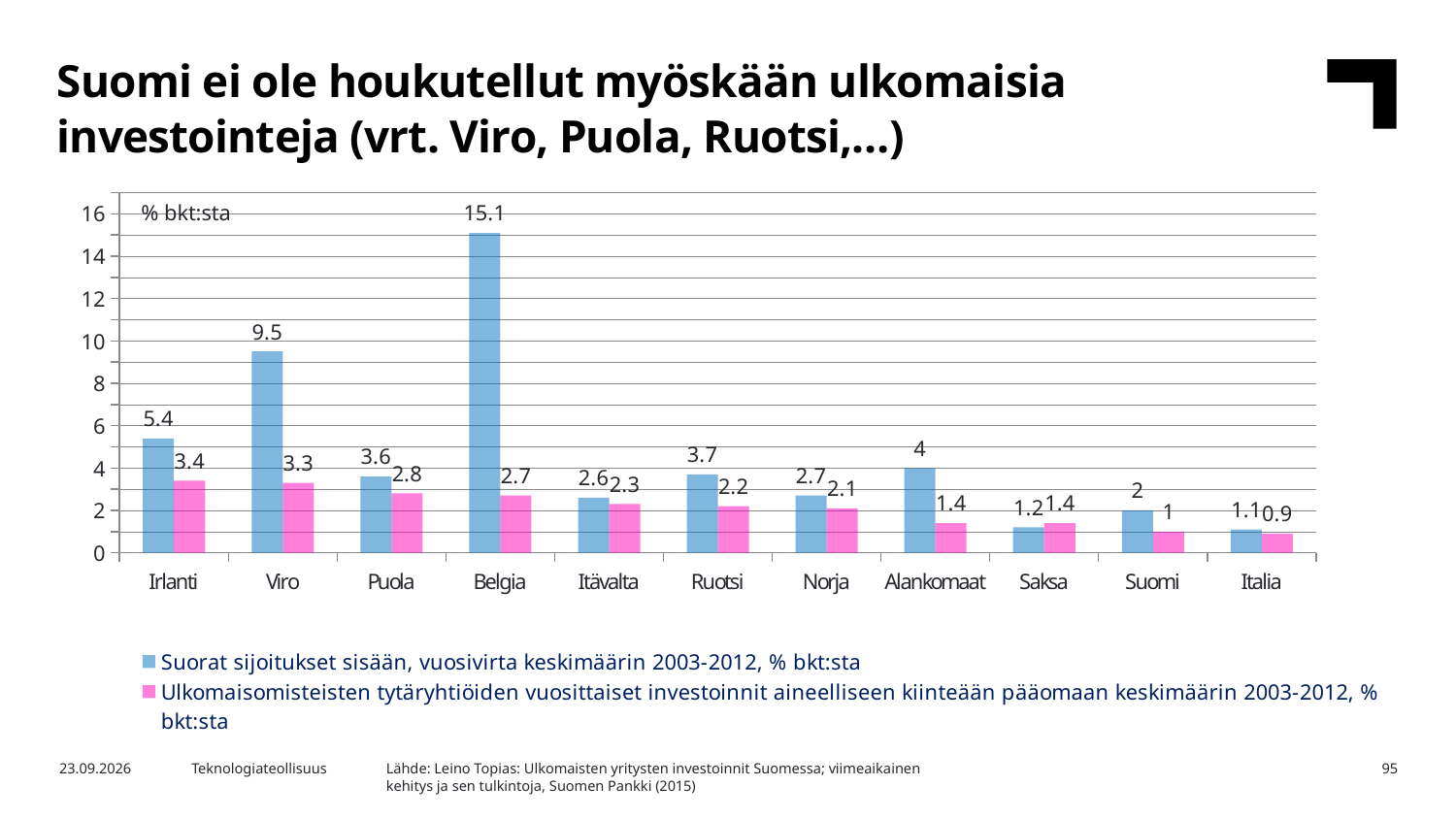
How many countries are shown on the x axis? 11 What kind of chart is shown on the slide? bar chart Is the blue series value for Irlanti greater or less than 4? greater Which country has the lowest value in the pink series (Ulkomaisomisteisten tytäryhtiöiden investoinnit)? Italia What unit label is shown at the top left of the chart area? % bkt:sta What is the value of the blue series (Suorat sijoitukset sisään) for Belgia? 15.1 Which country has the highest value in the blue series (Suorat sijoitukset sisään)? Belgia What is the value of the pink series (Ulkomaisomisteisten tytäryhtiöiden investoinnit) for Suomi? 1 What is the value of the blue series for Viro? 9.5 How many series does the legend list? 2 Which is larger for Saksa: the blue series value or the pink series value? the pink series (1.4) What is the difference between the blue and pink values for Belgia? 12.4